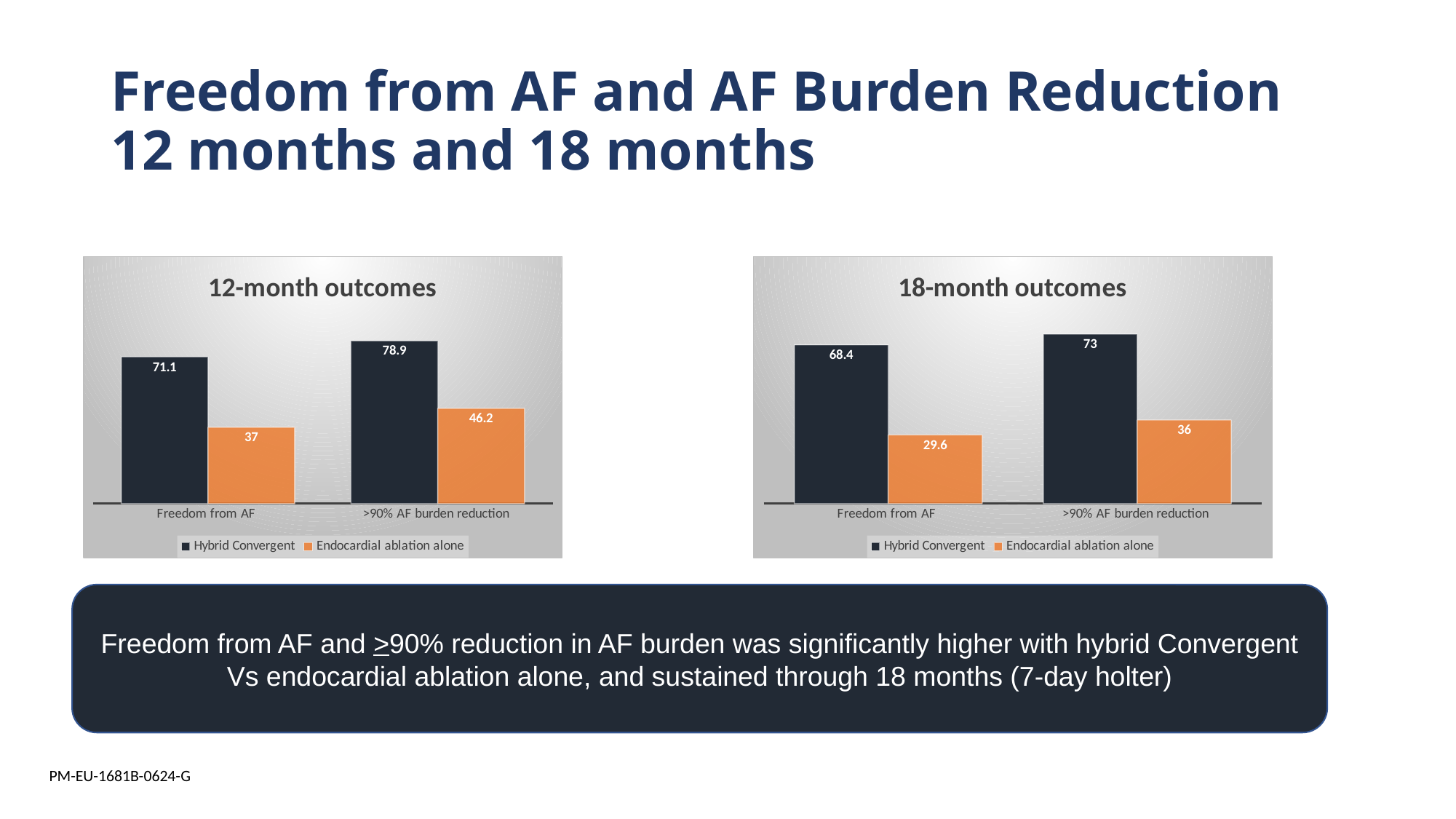
In the 18-month outcomes chart, what is the difference between Hybrid Convergent and Endocardial ablation alone for >90% AF burden reduction? 37 In the 18-month outcomes chart, which bar has the lowest value? Endocardial ablation alone, Freedom from AF In the 12-month outcomes chart, what is the value for Endocardial ablation alone for >90% AF burden reduction? 46.2 What kind of chart is the 12-month outcomes chart? Bar chart In the 12-month outcomes chart, what is the value for Hybrid Convergent for Freedom from AF? 71.1 How many categories are shown on the x axis of the 18-month outcomes chart? 2 In the 18-month outcomes chart, what is the value for Hybrid Convergent for >90% AF burden reduction? 73 In the 12-month outcomes chart, what is the difference between Hybrid Convergent and Endocardial ablation alone for Freedom from AF? 34.1 In the 18-month outcomes chart, what is the value for Endocardial ablation alone for Freedom from AF? 29.6 In the 12-month outcomes chart, which bar has the highest value? Hybrid Convergent, >90% AF burden reduction In the 18-month outcomes chart, which is larger for Freedom from AF: Hybrid Convergent or Endocardial ablation alone? Hybrid Convergent How many series does the legend of the 12-month outcomes chart list? 2